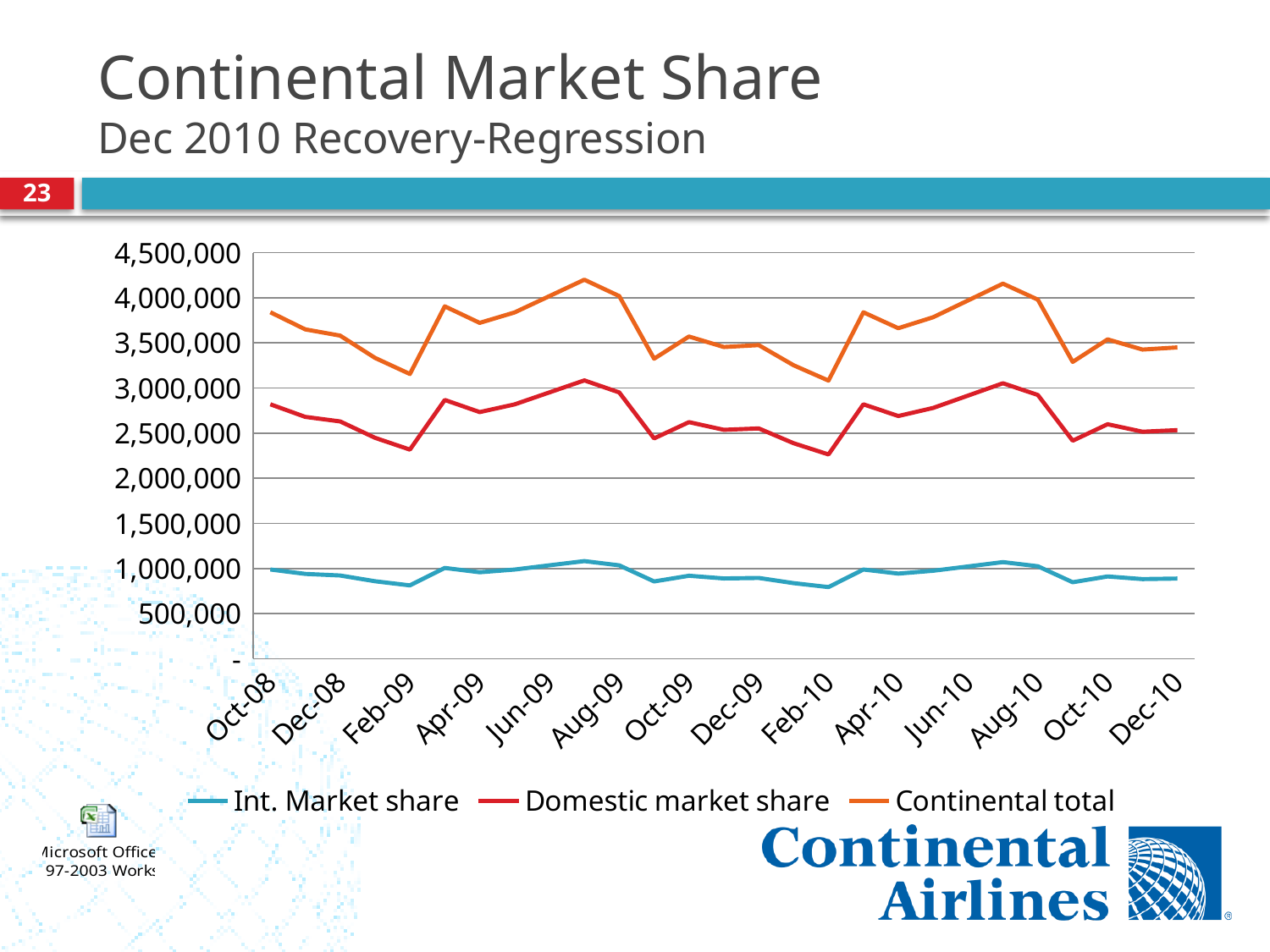
How many month labels are shown on the x axis? 14 What kind of chart is shown on the slide? line chart Which is larger at Apr-10, Domestic market share or Int. Market share? Domestic market share Is the Int. Market share value for Feb-10 greater or less than 1,000,000? less How many series does the legend list? 3 Is the Domestic market share value for Feb-10 greater or less than 2,500,000? less Is the Continental total value for Feb-09 greater or less than 3,500,000? less Does the Continental total rise or fall from Oct-08 to Feb-09? fall Which series has the highest values throughout the chart? Continental total What are the three series named in the legend? Int. Market share, Domestic market share, Continental total Which series has the lowest values throughout the chart? Int. Market share